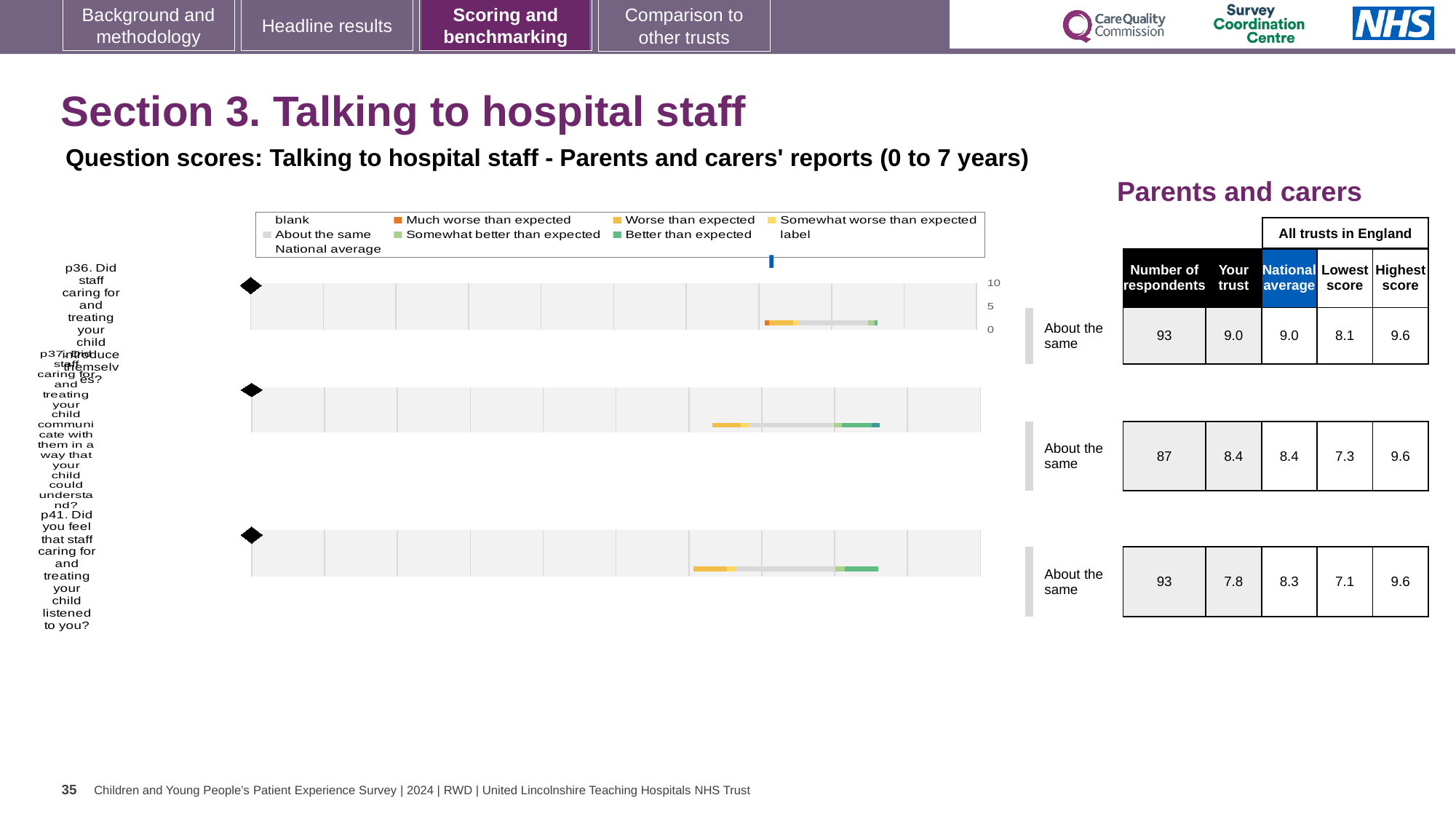
What is the difference between the national average and the 'Your trust' score for question p41? 0.5 What is the 'Your trust' score for question p36? 9.0 Which question has the highest 'Your trust' score? p36 What is the lowest score among all trusts in England for question p41? 7.1 Which question has the lowest 'Your trust' score? p41 What is the national average score for question p41? 8.3 How many question charts are shown on the slide? 3 What kind of chart is used for each question (p36, p37, p41)? bar chart What is the maximum value shown on the chart axis? 10 What benchmark category is shown for question p37? About the same Which is larger, the 'Your trust' score for p36 or for p41? p36 How many respondents answered question p37? 87